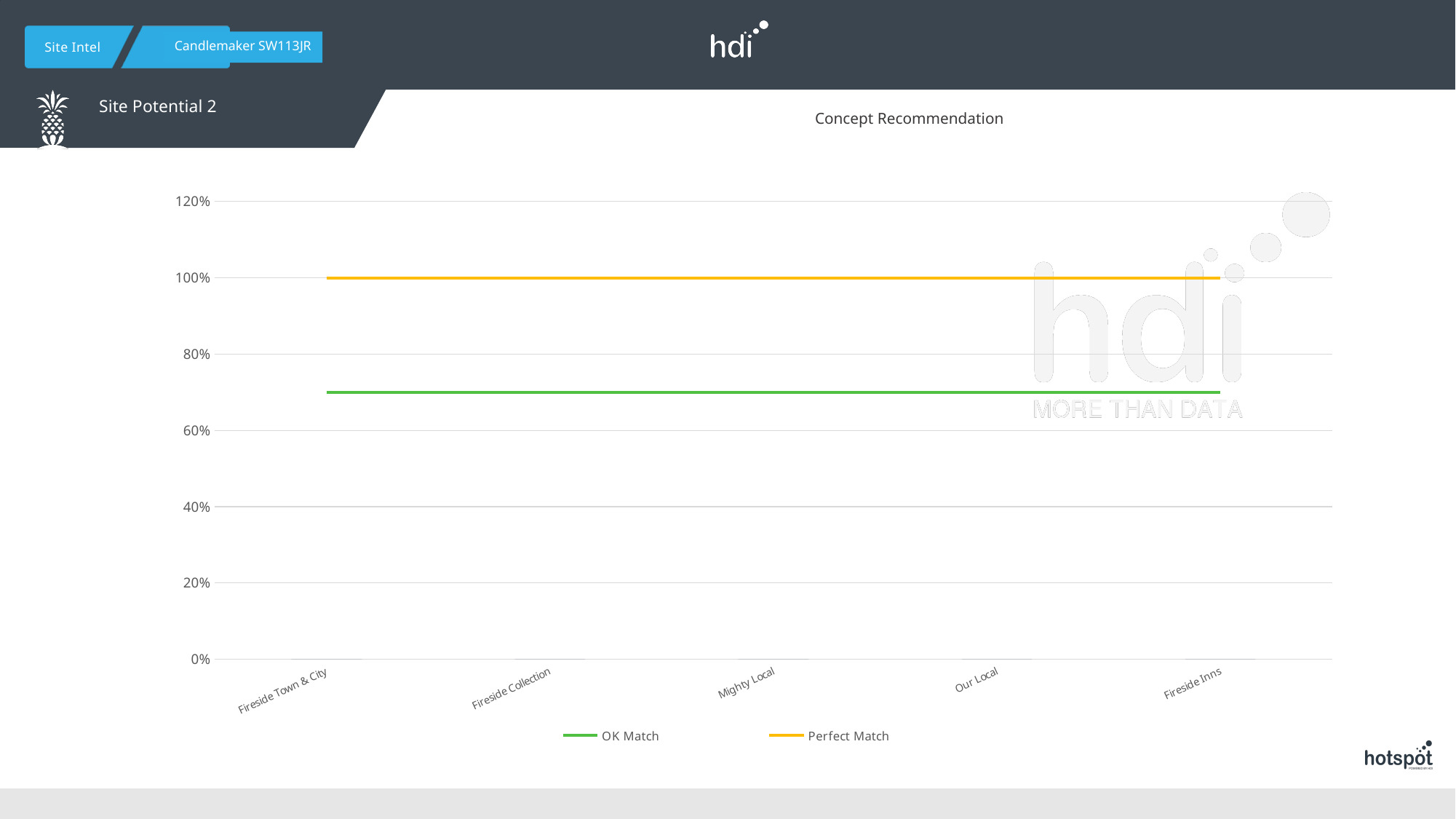
Is the value of the OK Match line at Our Local greater or less than 60%? greater Does the Perfect Match line rise, fall or stay flat across the categories? stays flat What kind of chart is shown on the slide? line chart How many categories are shown on the x axis? 5 How many series does the legend list? 2 What is the title of the chart? Concept Recommendation Does the OK Match line rise, fall or stay flat across the categories? stays flat Which series are listed in the legend? OK Match, Perfect Match Is the value of the OK Match line at Fireside Collection greater or less than 80%? less What is the value of the Perfect Match line at Mighty Local? 100% What is the value of the Perfect Match line at Fireside Inns? 100% Which series has the higher value at Fireside Town & City, OK Match or Perfect Match? Perfect Match